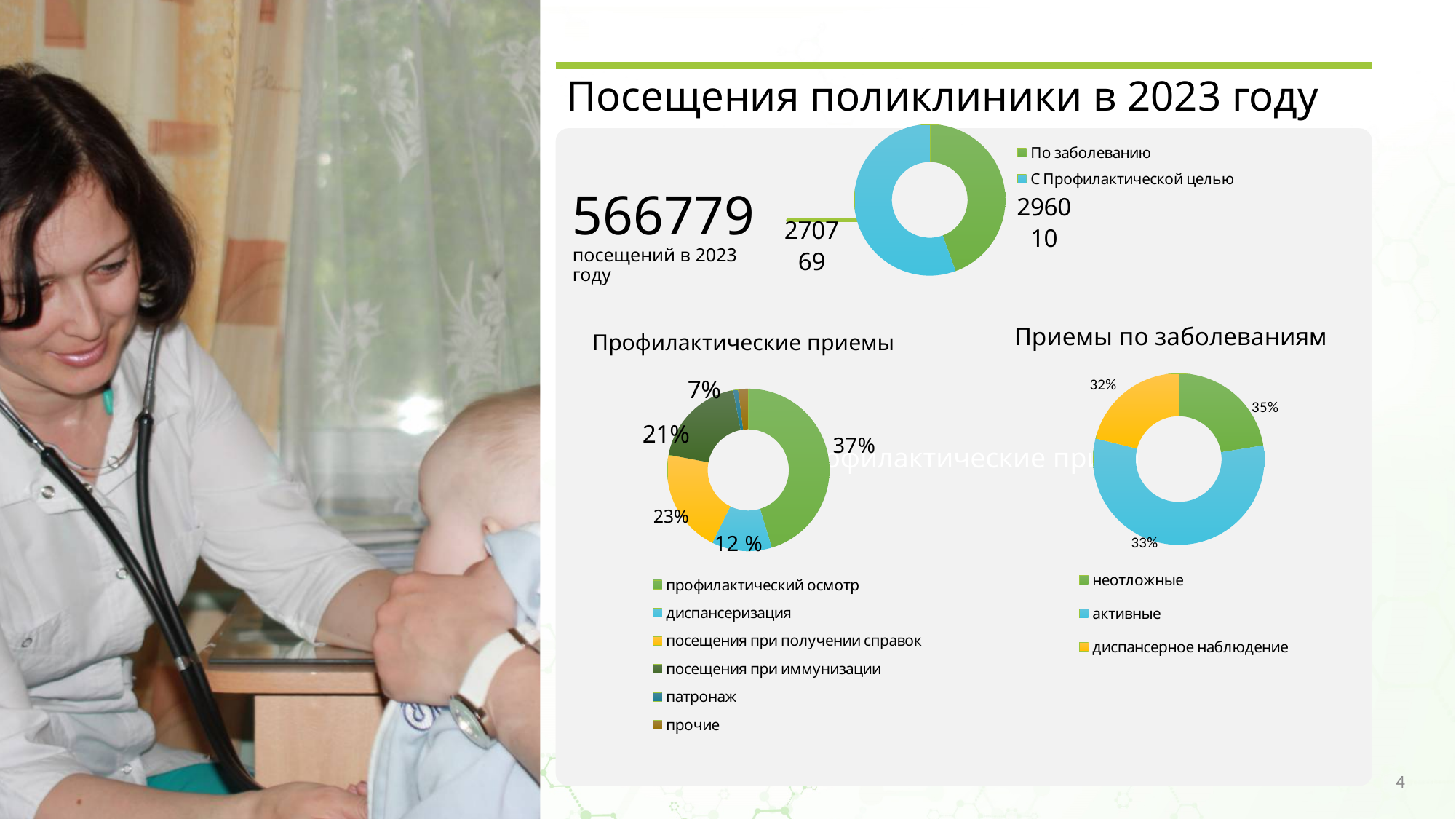
In the 'Профилактические приемы' chart, which category has the largest share? профилактический осмотр In the 'Приемы по заболеваниям' chart, what share is 'диспансерное наблюдение'? 32% What kind of chart is used for 'Профилактические приемы'? pie chart (donut) How many categories does the legend of the 'Профилактические приемы' chart list? 6 In the 'Приемы по заболеваниям' chart, what share is 'активные'? 33% How many categories does the legend of the 'Приемы по заболеваниям' chart list? 3 In the 'Профилактические приемы' chart, what share is 'профилактический осмотр'? 37% In the 'Профилактические приемы' chart, what share is 'посещения при получении справок'? 23% In the 'Профилактические приемы' chart, what share is 'диспансеризация'? 12 % In the 'Приемы по заболеваниям' chart, what share is 'неотложные'? 35% In the 'Профилактические приемы' chart, what share is 'посещения при иммунизации'? 21%